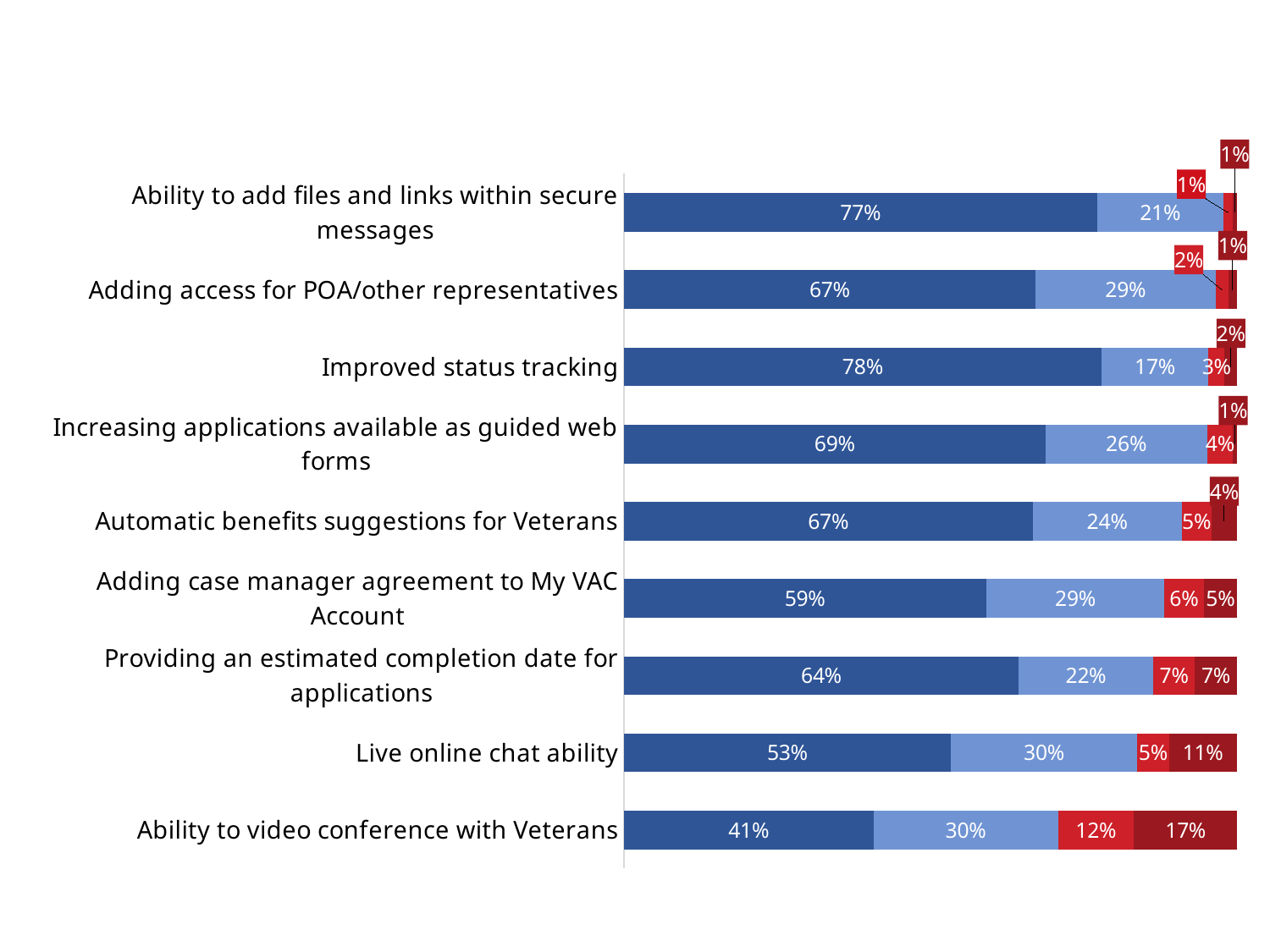
What is the difference between the dark blue segment for "Improved status tracking" and the dark blue segment for "Ability to video conference with Veterans"? 37 percentage points What is the value of the dark blue (first) segment for "Improved status tracking"? 78% What is the value of the red (third) segment for "Providing an estimated completion date for applications"? 7% Which category has the largest dark blue (first) segment? Improved status tracking How many coloured segments make up each stacked bar? 4 What is the value of the dark red (last) segment for "Live online chat ability"? 11% Which category has the smallest dark blue (first) segment? Ability to video conference with Veterans How many categories are plotted in the chart? 9 What is the total of all segments in the bar for "Ability to video conference with Veterans"? 100% What is the value of the light blue (second) segment for "Live online chat ability"? 30% What kind of chart is shown on the slide? Bar chart Which has the larger light blue (second) segment: "Adding access for POA/other representatives" or "Improved status tracking"? Adding access for POA/other representatives